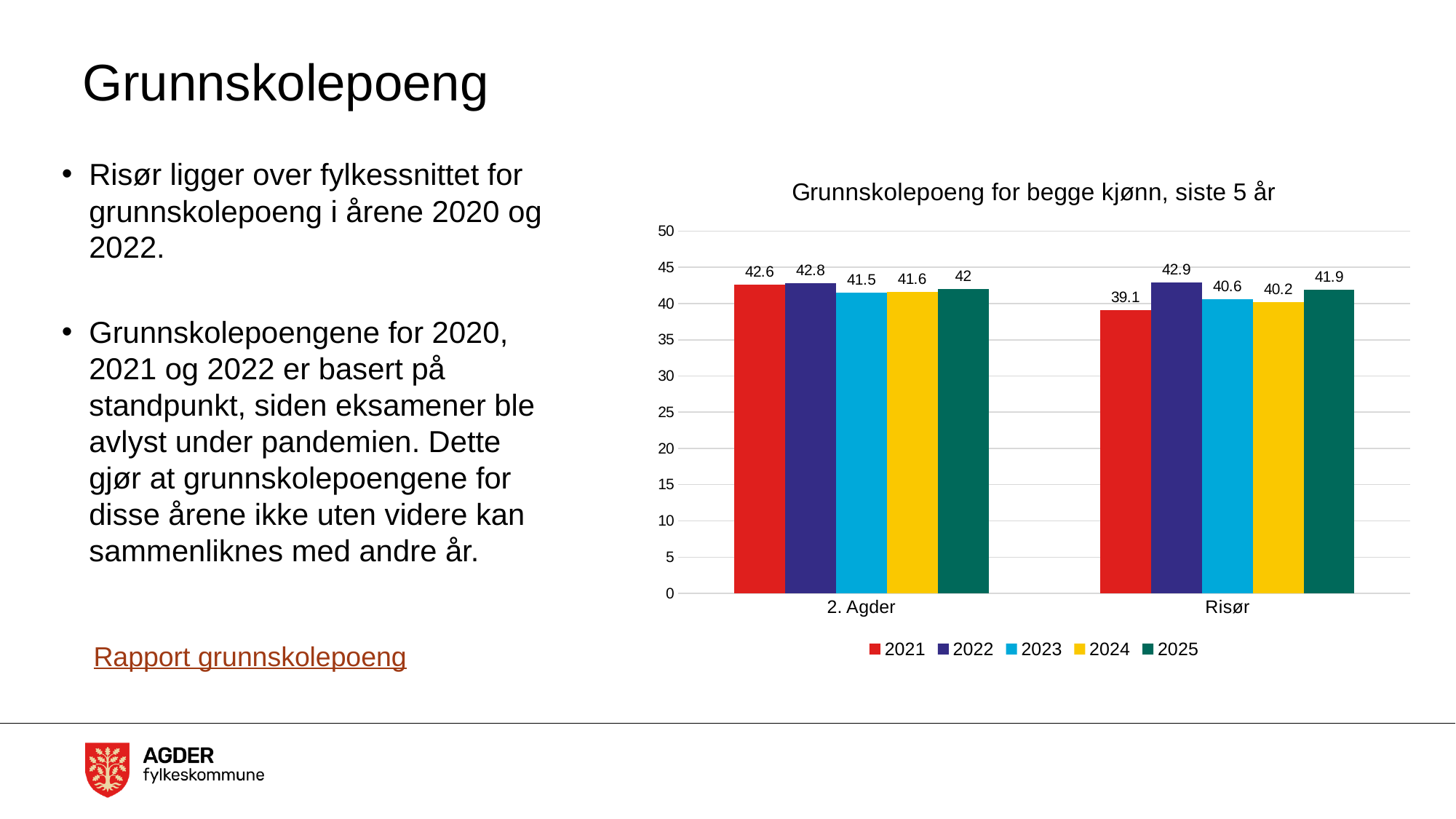
What is the difference between the 2021 values for 2. Agder and Risør? 3.5 What is the value for Risør in 2025? 41.9 What is the value for 2. Agder in 2021? 42.6 How many categories are shown on the x axis? 2 What is the title of the chart? Grunnskolepoeng for begge kjønn, siste 5 år Which year has the lowest value for Risør? 2021 Which is larger, the 2023 value for 2. Agder or the 2023 value for Risør? 2. Agder What kind of chart is shown? Bar chart What is the value for Risør in 2022? 42.9 Which colour represents 2024 in the legend? Yellow How many series does the legend list? 5 Which year has the highest value for 2. Agder? 2022